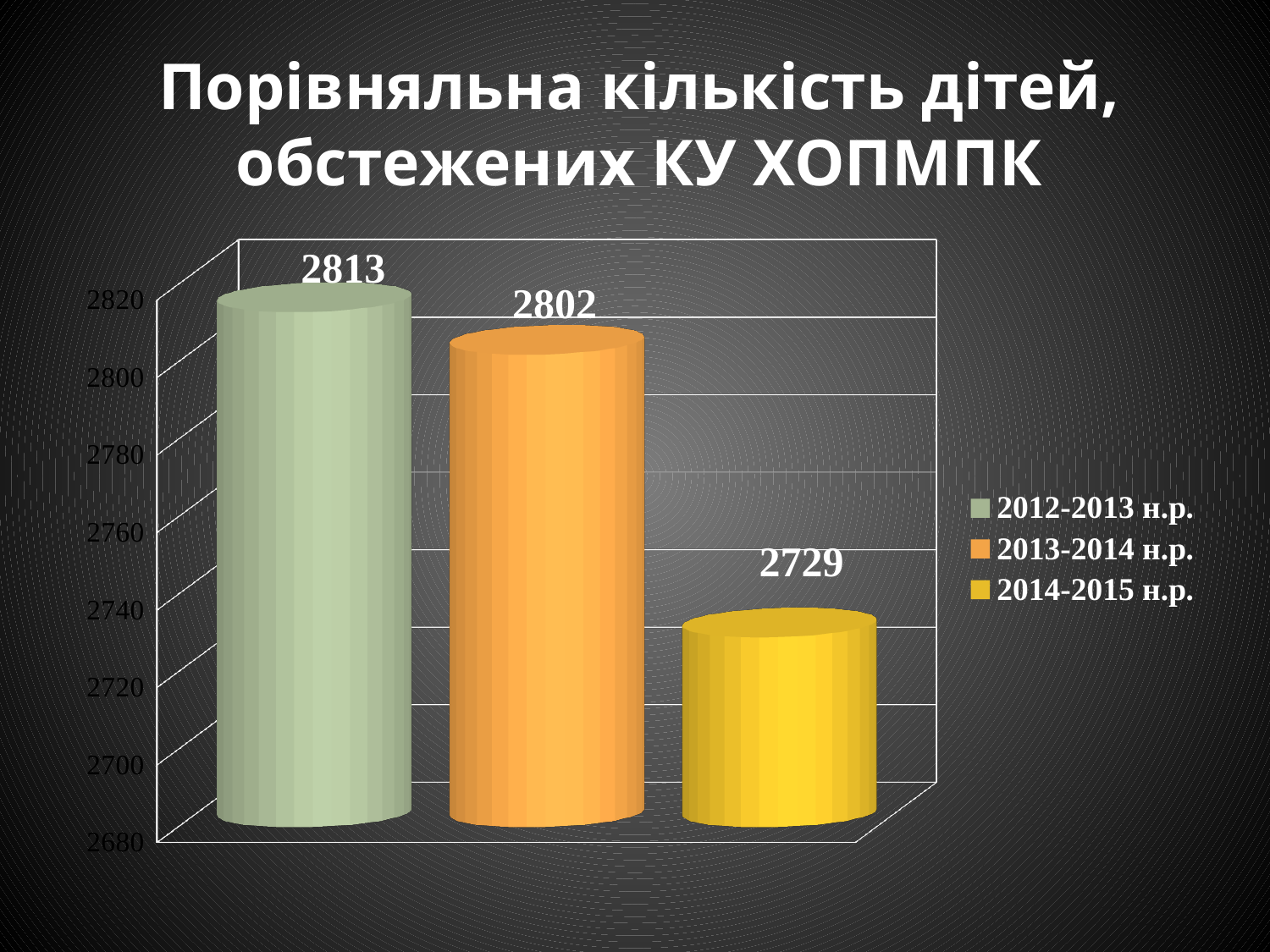
Do the values rise or fall from 2012-2013 н.р. to 2014-2015 н.р.? fall What kind of chart is shown on the slide? bar chart Which is larger, the value for 2013-2014 н.р. or 2014-2015 н.р.? 2013-2014 н.р. Which school year has the highest value? 2012-2013 н.р. What is the value for 2013-2014 н.р.? 2802 How many series does the legend list? 3 Is the value for 2014-2015 н.р. greater or less than 2740? less What is the value for 2012-2013 н.р.? 2813 Which school year has the lowest value? 2014-2015 н.р. What is the difference between the values for 2012-2013 н.р. and 2014-2015 н.р.? 84 What is the difference between the values for 2013-2014 н.р. and 2014-2015 н.р.? 73 What is the value for 2014-2015 н.р.? 2729